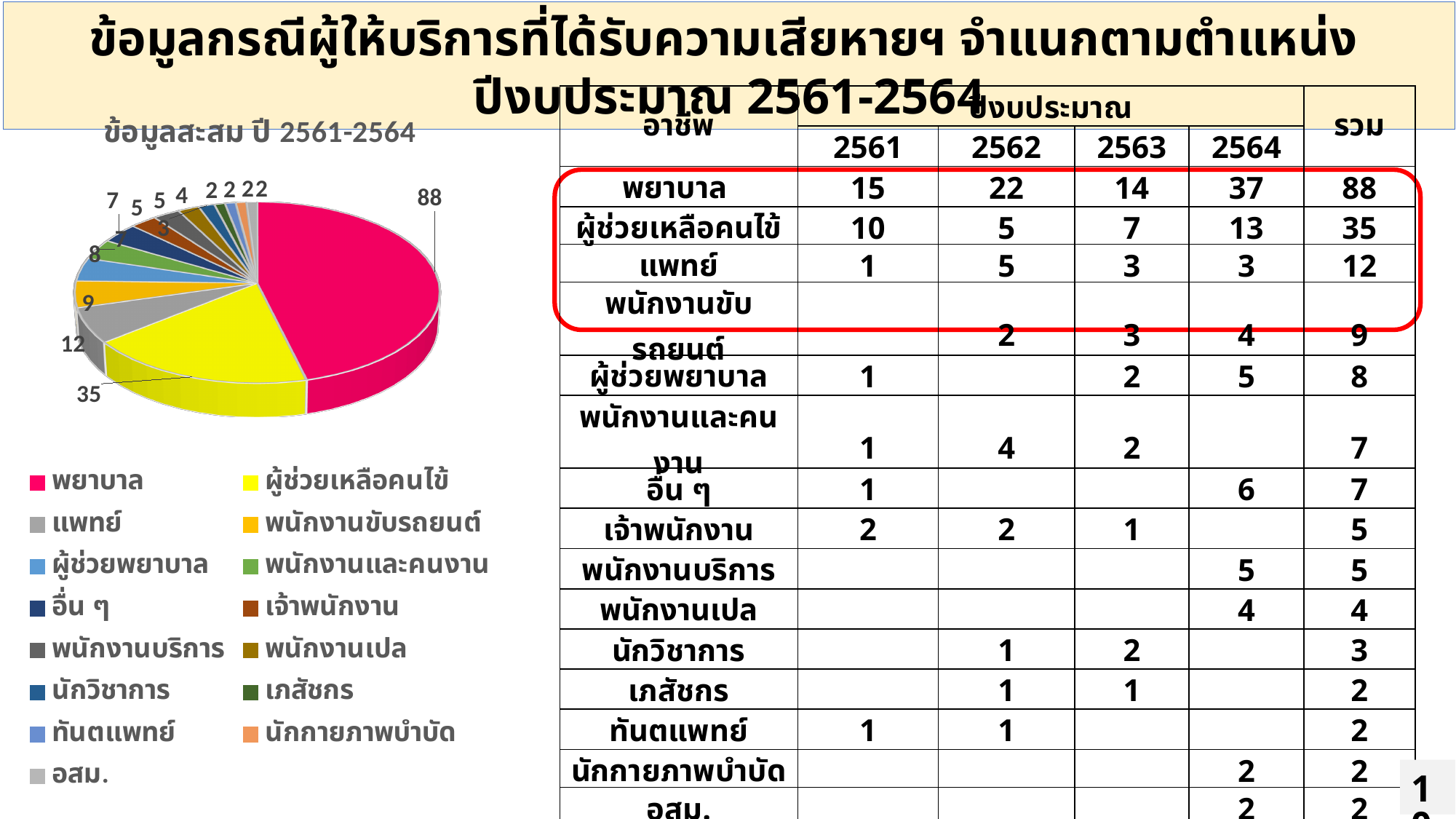
Which category has the largest slice in the pie chart? พยาบาล In the pie chart, what is the difference between the values for ผู้ช่วยเหลือคนไข้ and แพทย์? 23 In the pie chart, what is the difference between the values for พยาบาล and ผู้ช่วยเหลือคนไข้? 53 In the pie chart, what is the value for พนักงานขับรถยนต์? 9 What colour is the พยาบาล slice in the pie chart? Pink In the pie chart, what is the value for พยาบาล? 88 In the pie chart, which is larger: the value for แพทย์ or the value for พนักงานขับรถยนต์? แพทย์ What kind of chart is shown on the left of the slide? Pie chart How many categories does the pie chart's legend list? 15 In the pie chart, what is the value for แพทย์? 12 What is the title of the pie chart? ข้อมูลสะสม ปี 2561-2564 In the pie chart, what is the value for ผู้ช่วยเหลือคนไข้? 35